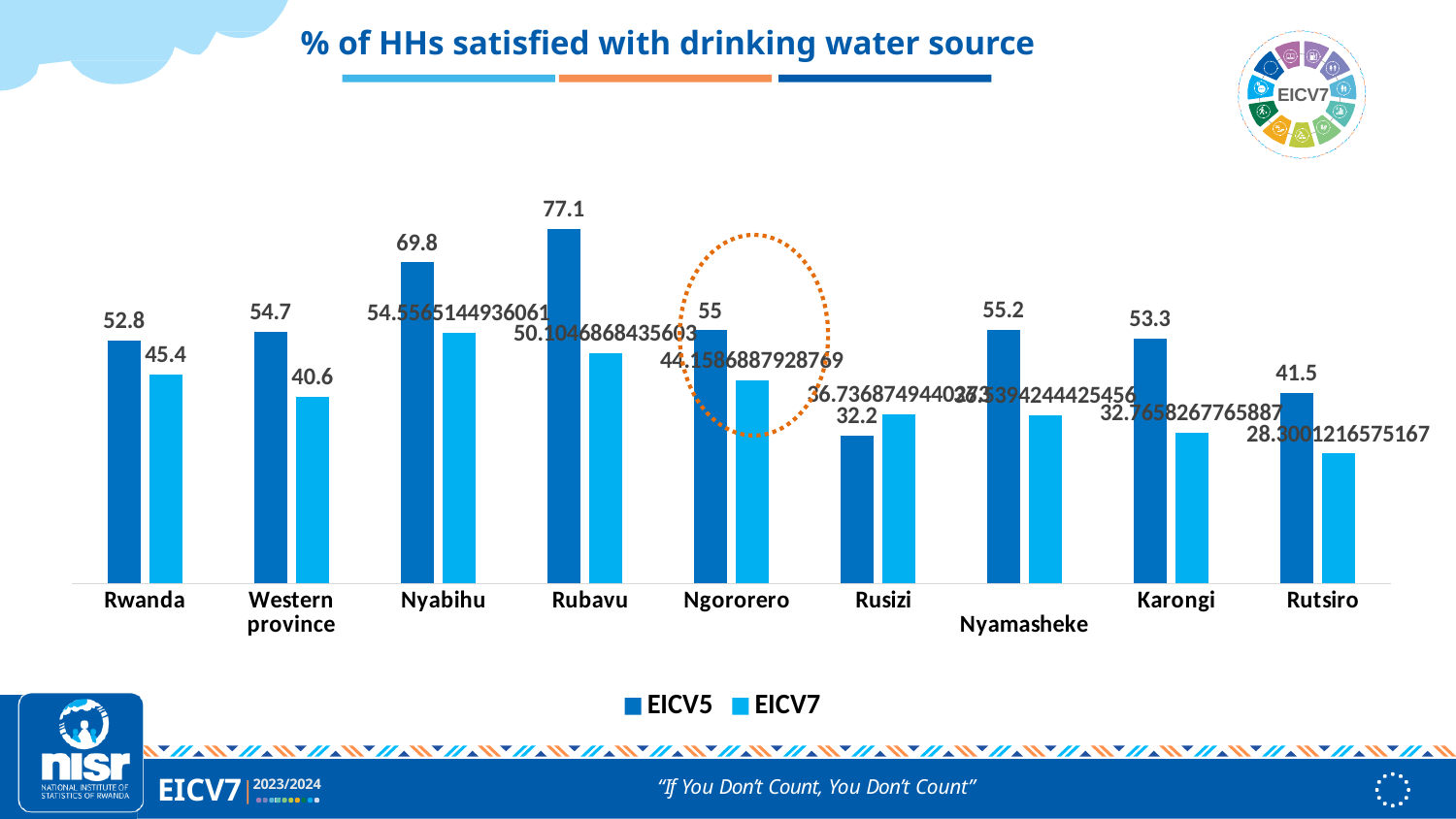
What is the EICV5 value for Rubavu? 77.1 How many series does the legend list? 2 What is the difference between the EICV5 and EICV7 values for Rwanda? 7.4 Which category has the lowest EICV5 value? Rusizi What kind of chart is shown on the slide? bar chart What is the title of the chart? % of HHs satisfied with drinking water source Which category has the lowest EICV7 value? Rutsiro Which is larger, the EICV5 value for Nyabihu or the EICV5 value for Rutsiro? Nyabihu What is the EICV7 value for Western province? 40.6 What is the EICV5 value for Rwanda? 52.8 Which category has the highest EICV5 value? Rubavu How many categories are shown on the x axis? 9